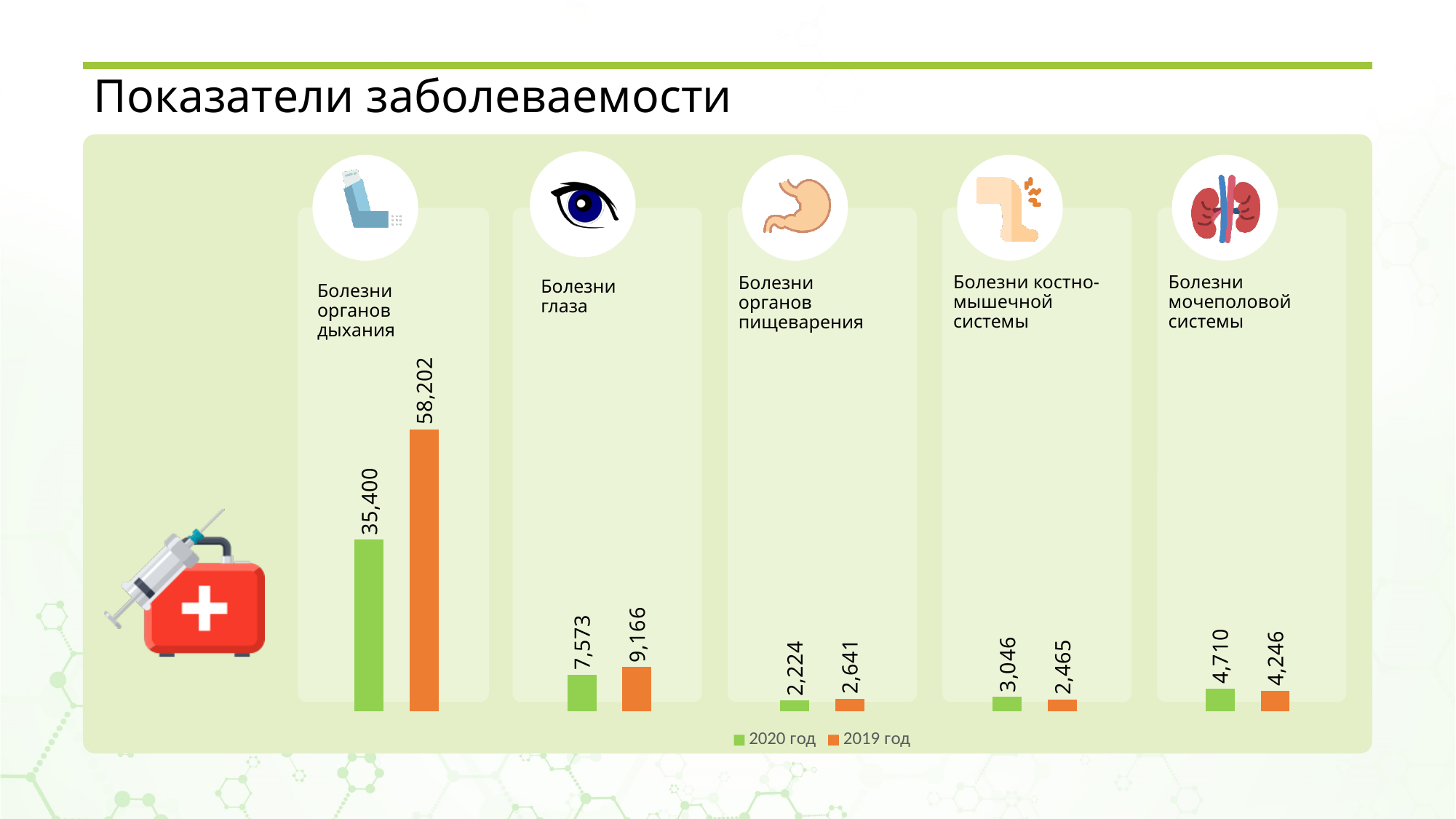
For Болезни мочеполовой системы, which series has the larger value, 2020 год or 2019 год? 2020 год What is the 2019 год value for Болезни глаза? 9,166 What is the value for Болезни органов дыхания in the 2020 год series? 35,400 What is the difference between the 2020 год and 2019 год values for Болезни костно-мышечной системы? 581 What is the value for Болезни органов дыхания in the 2019 год series? 58,202 What is the difference between the 2019 год and 2020 год values for Болезни органов дыхания? 22,802 What is the 2020 год value for Болезни мочеполовой системы? 4,710 Which category has the lowest 2020 год value? Болезни органов пищеварения How many disease categories are shown in the chart? 5 How many series does the legend list? 2 Which category has the highest 2019 год value? Болезни органов дыхания What type of chart is shown on the slide? Bar chart